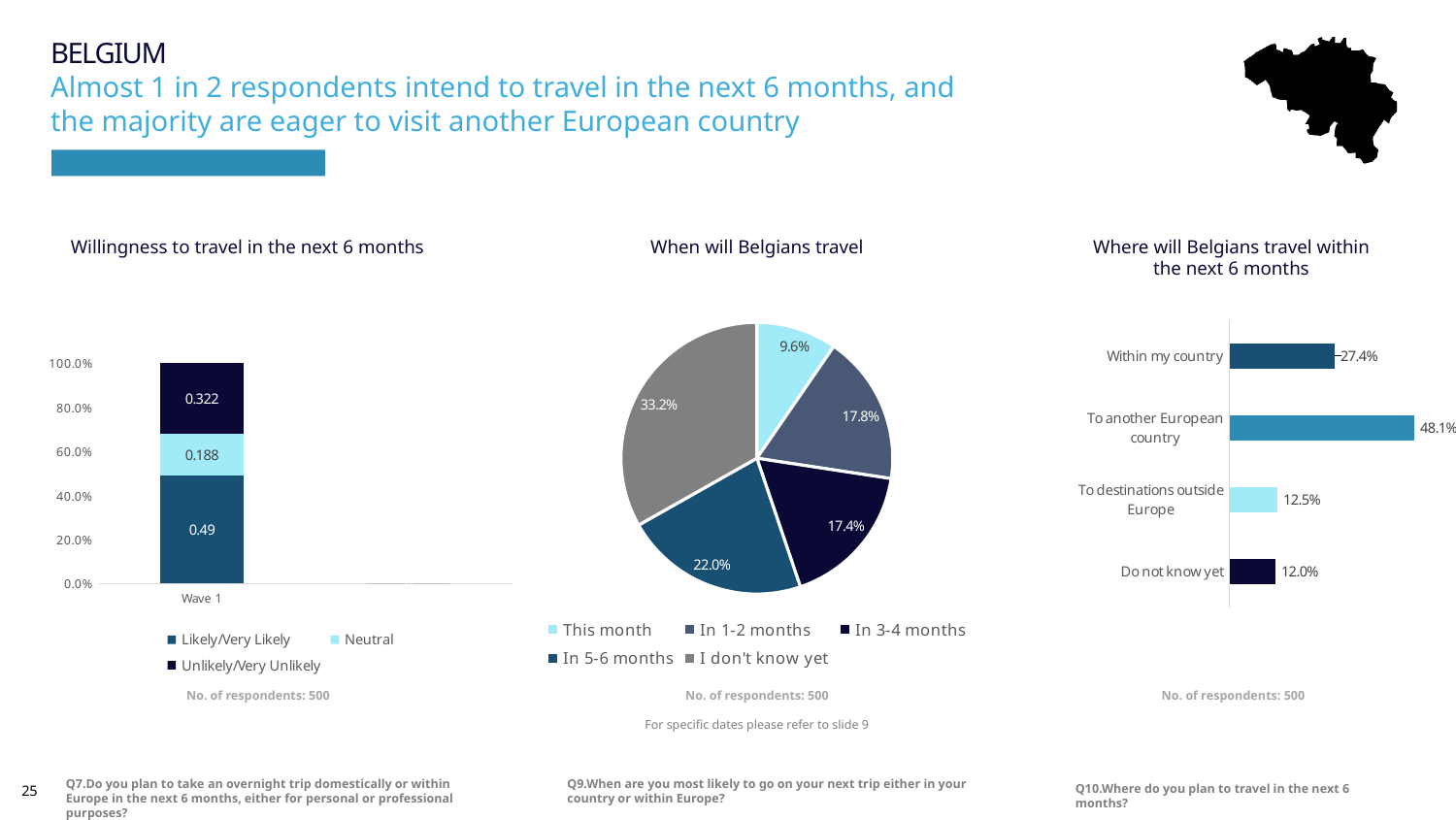
In the 'When will Belgians travel' pie chart, which slice is the smallest? This month In the 'Where will Belgians travel within the next 6 months' chart, which is larger: 'To destinations outside Europe' or 'Do not know yet'? To destinations outside Europe In the 'Where will Belgians travel within the next 6 months' chart, what is the difference between 'Within my country' and 'Do not know yet'? 15.4% In the 'Where will Belgians travel within the next 6 months' chart, what is the value for 'To another European country'? 48.1% In the 'When will Belgians travel' pie chart, what share is 'In 5-6 months'? 22.0% In the 'Willingness to travel in the next 6 months' chart, what is the total of the stacked bar for Wave 1? 1 How many slices does the 'When will Belgians travel' pie chart have? 5 In the 'Willingness to travel in the next 6 months' chart, what is the value for Neutral? 0.188 What kind of chart is 'When will Belgians travel'? Pie chart In the 'Willingness to travel in the next 6 months' chart, what is the value for Likely/Very Likely in Wave 1? 0.49 How many series does the legend of the 'Willingness to travel in the next 6 months' chart list? 3 In the 'When will Belgians travel' pie chart, which slice is the largest? I don't know yet